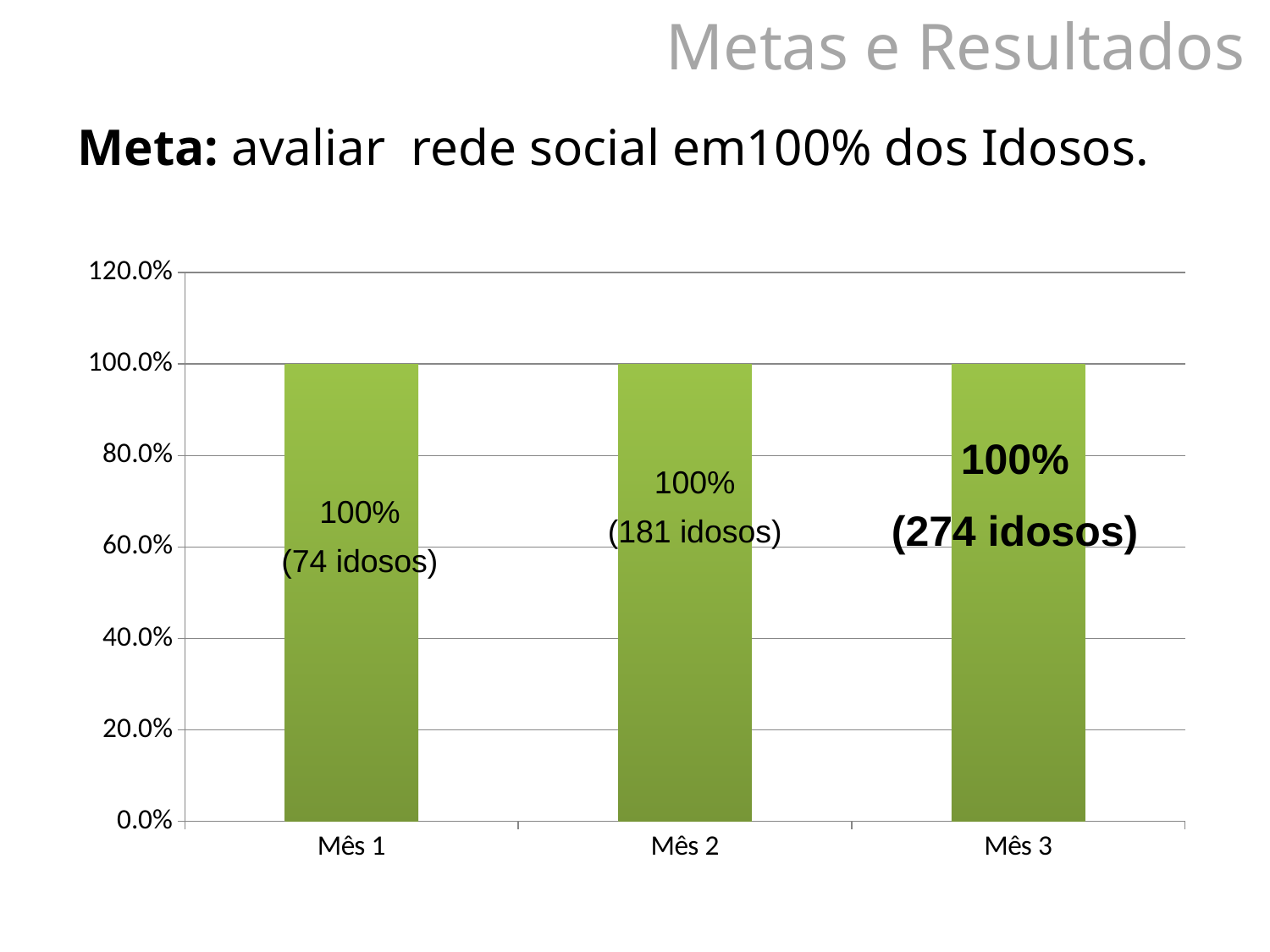
Which month has the largest number of idosos in its label? Mês 3 What is the difference between the number of idosos for Mês 3 and Mês 2? 93 How many idosos are indicated in the label for Mês 2? 181 idosos What percentage is shown for Mês 1? 100% How many idosos are indicated in the label for Mês 1? 74 idosos Which has more idosos, Mês 1 or Mês 2? Mês 2 Which month has the smallest number of idosos in its label? Mês 1 Do the percentage values rise, fall, or stay the same from Mês 1 to Mês 3? Stay the same How many idosos are indicated in the label for Mês 3? 274 idosos What type of chart is shown on the slide? Bar chart How many bars are shown in the chart? 3 What is the difference between the number of idosos for Mês 2 and Mês 1? 107